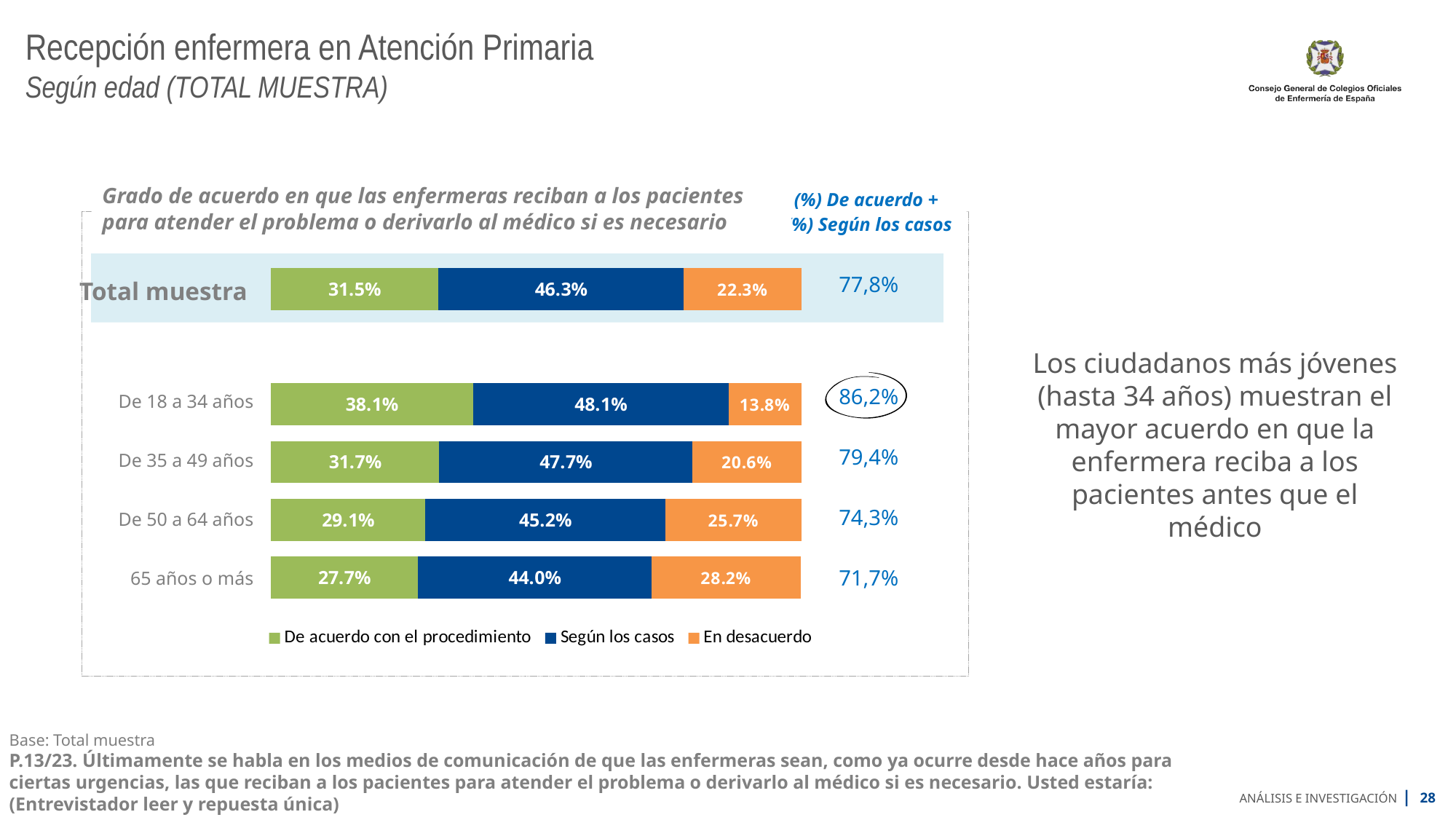
Which age group has the highest 'De acuerdo con el procedimiento' percentage? De 18 a 34 años Which age group has the lowest 'En desacuerdo' percentage? De 18 a 34 años What is the 'Según los casos' value for 'Total muestra'? 46.3% What percentage of the 'De 18 a 34 años' group answered 'De acuerdo con el procedimiento'? 38.1% What is the combined '(%) De acuerdo + (%) Según los casos' value shown for 'De 50 a 64 años'? 74,3% What is the 'En desacuerdo' value for '65 años o más'? 28.2% What kind of chart is shown on the slide? Stacked bar chart Which colour represents 'En desacuerdo' in the legend? Orange How many bars are shown in the chart, including 'Total muestra'? 5 Which is larger: the 'Según los casos' value for 'De 35 a 49 años' or for 'De 50 a 64 años'? De 35 a 49 años How many series does the legend list? 3 What is the difference between the 'En desacuerdo' values for '65 años o más' and 'De 18 a 34 años'? 14.4%